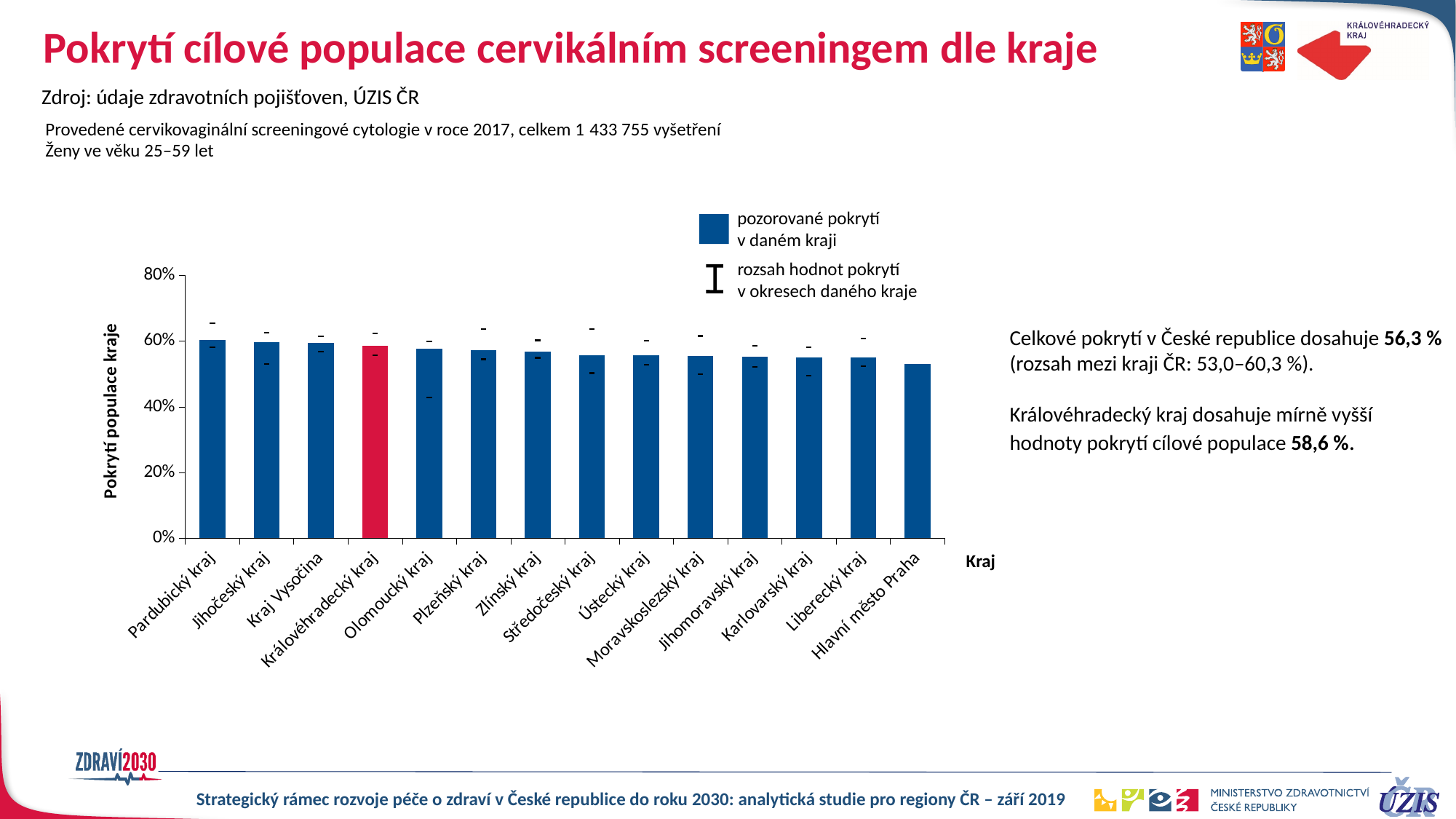
Is the value for Hlavní město Praha greater or less than 60%? less Which is larger, the coverage for Královéhradecký kraj or for Liberecký kraj? Královéhradecký kraj Do the bar values rise or fall from left to right along the x axis? fall Which is larger, the coverage for Pardubický kraj or for Hlavní město Praha? Pardubický kraj How many entries does the chart legend list? 2 Which region has the lowest observed coverage in the chart? Hlavní město Praha Which bar in the chart is coloured red instead of blue? Královéhradecký kraj How many regions (kraje) are plotted on the x axis of the chart? 14 What kind of chart is shown on the slide? bar chart Which region has the highest observed coverage in the chart? Pardubický kraj What coverage value does the slide state for Královéhradecký kraj? 58,6 % Is the value for Olomoucký kraj greater or less than 40%? greater